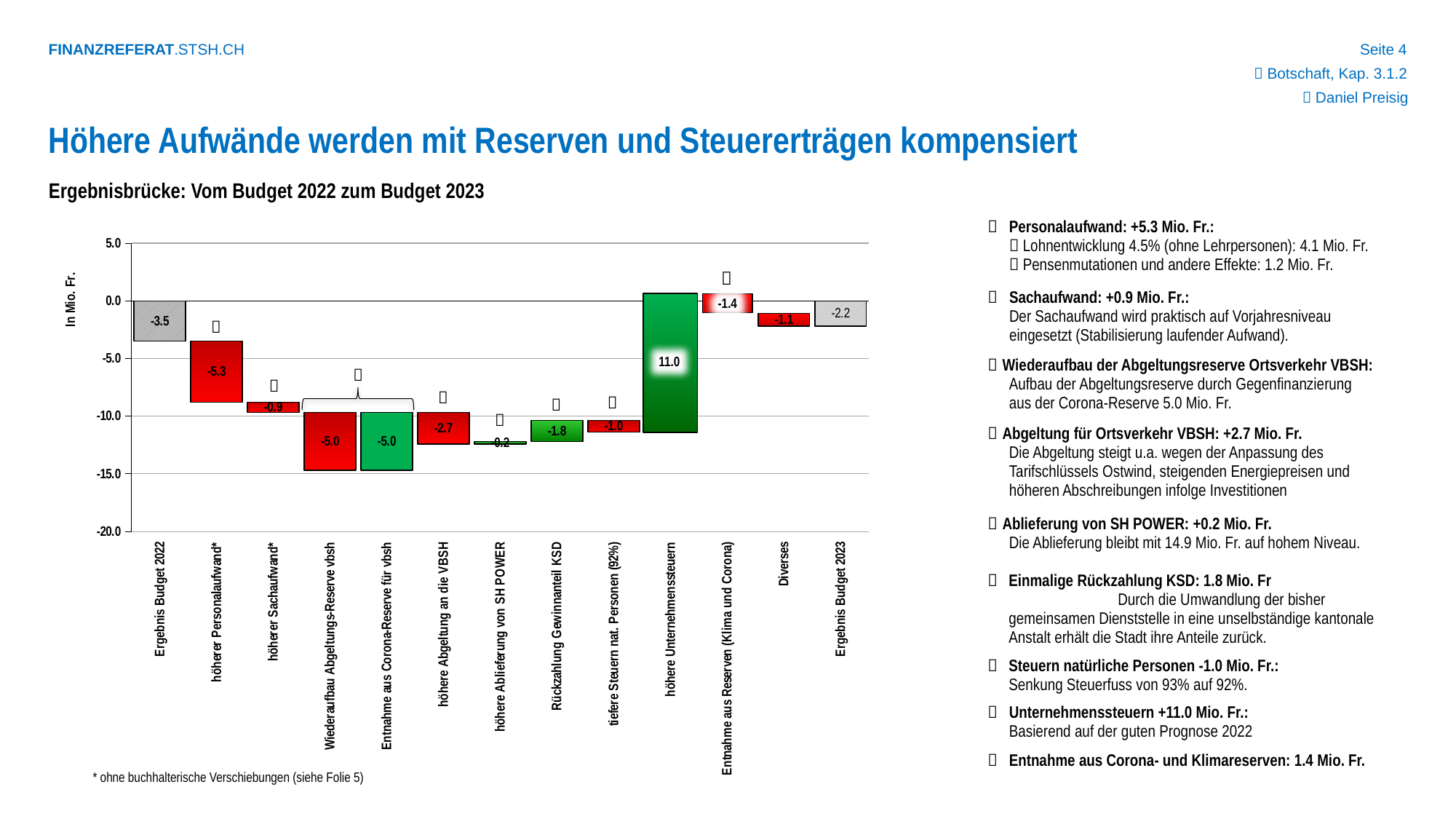
What value is labelled on the bar for 'Entnahme aus Reserven (Klima und Corona)'? -1.4 What value is labelled on the bar for 'Ergebnis Budget 2023'? -2.2 What kind of chart is shown on the slide? Bar chart (waterfall) What is the difference between the labelled values for 'höherer Personalaufwand*' (-5.3) and 'höherer Sachaufwand*' (-0.9)? 4.4 What value is labelled on the bar for 'höhere Unternehmenssteuern'? 11.0 What is the label of the vertical axis of the chart? In Mio. Fr. Which has the larger labelled magnitude: 'höhere Abgeltung an die VBSH' or 'Diverses'? höhere Abgeltung an die VBSH How many categories are shown on the x axis of the chart? 13 What value is labelled on the bar for 'Ergebnis Budget 2022'? -3.5 What value is labelled on the bar for 'Rückzahlung Gewinnanteil KSD'? -1.8 Which category has the largest labelled value in the chart? höhere Unternehmenssteuern What value is labelled on the bar for 'höherer Personalaufwand*'? -5.3